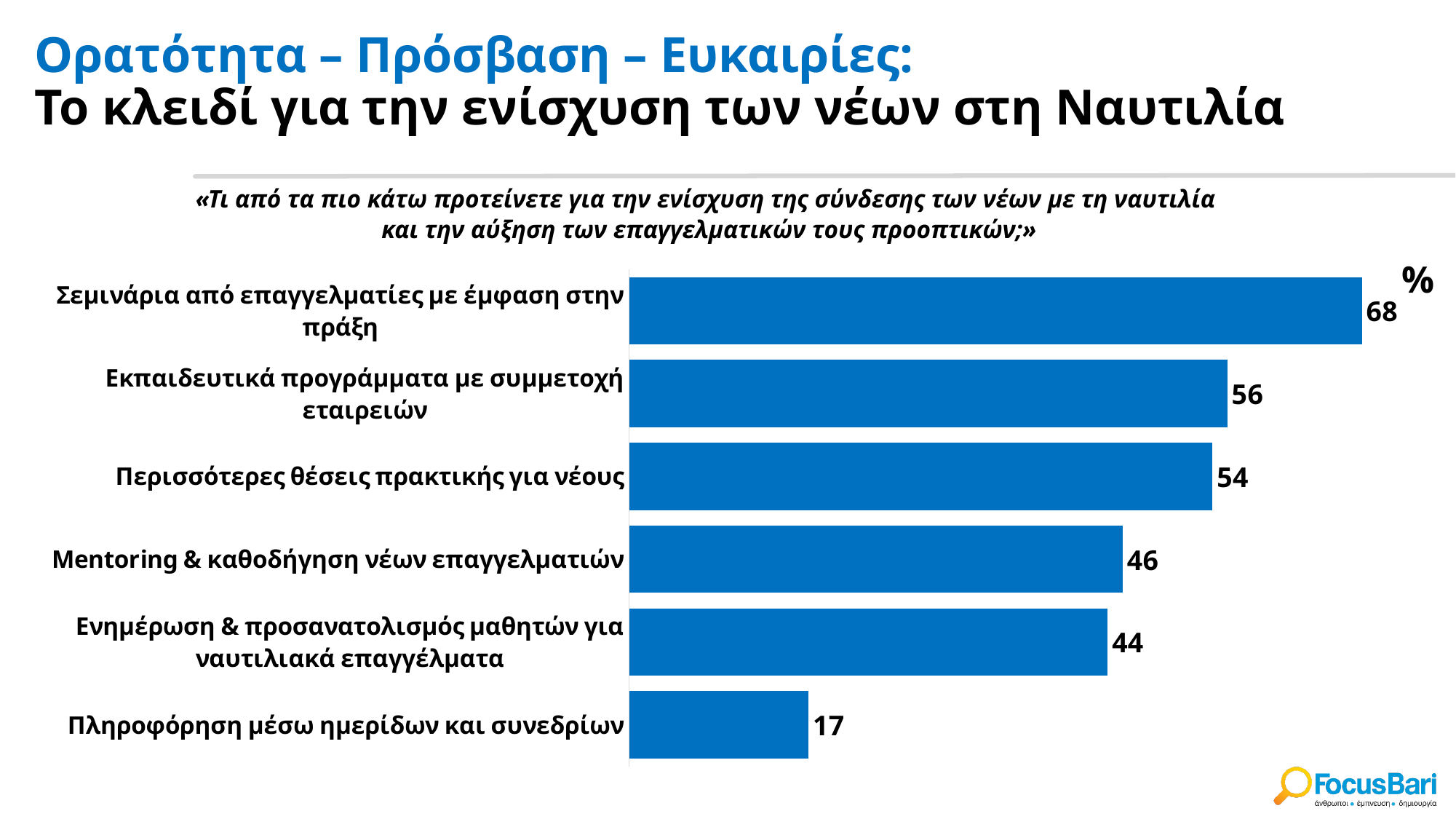
Which is larger: the value for «Εκπαιδευτικά προγράμματα με συμμετοχή εταιρειών» or «Περισσότερες θέσεις πρακτικής για νέους»? Εκπαιδευτικά προγράμματα με συμμετοχή εταιρειών What is the value for «Περισσότερες θέσεις πρακτικής για νέους»? 54 What is the value for «Πληροφόρηση μέσω ημερίδων και συνεδρίων»? 17 How many categories are shown on the chart? 6 What kind of chart is shown on the slide? Bar chart What is the difference between the values for «Εκπαιδευτικά προγράμματα με συμμετοχή εταιρειών» and «Ενημέρωση & προσανατολισμός μαθητών για ναυτιλιακά επαγγέλματα»? 12 What is the difference between the highest and lowest values on the chart? 51 What is the value for «Mentoring & καθοδήγηση νέων επαγγελματιών»? 46 What is the value for «Σεμινάρια από επαγγελματίες με έμφαση στην πράξη»? 68 Which category has the highest value? Σεμινάρια από επαγγελματίες με έμφαση στην πράξη Which category has the lowest value? Πληροφόρηση μέσω ημερίδων και συνεδρίων What unit are the values on the chart expressed in? %